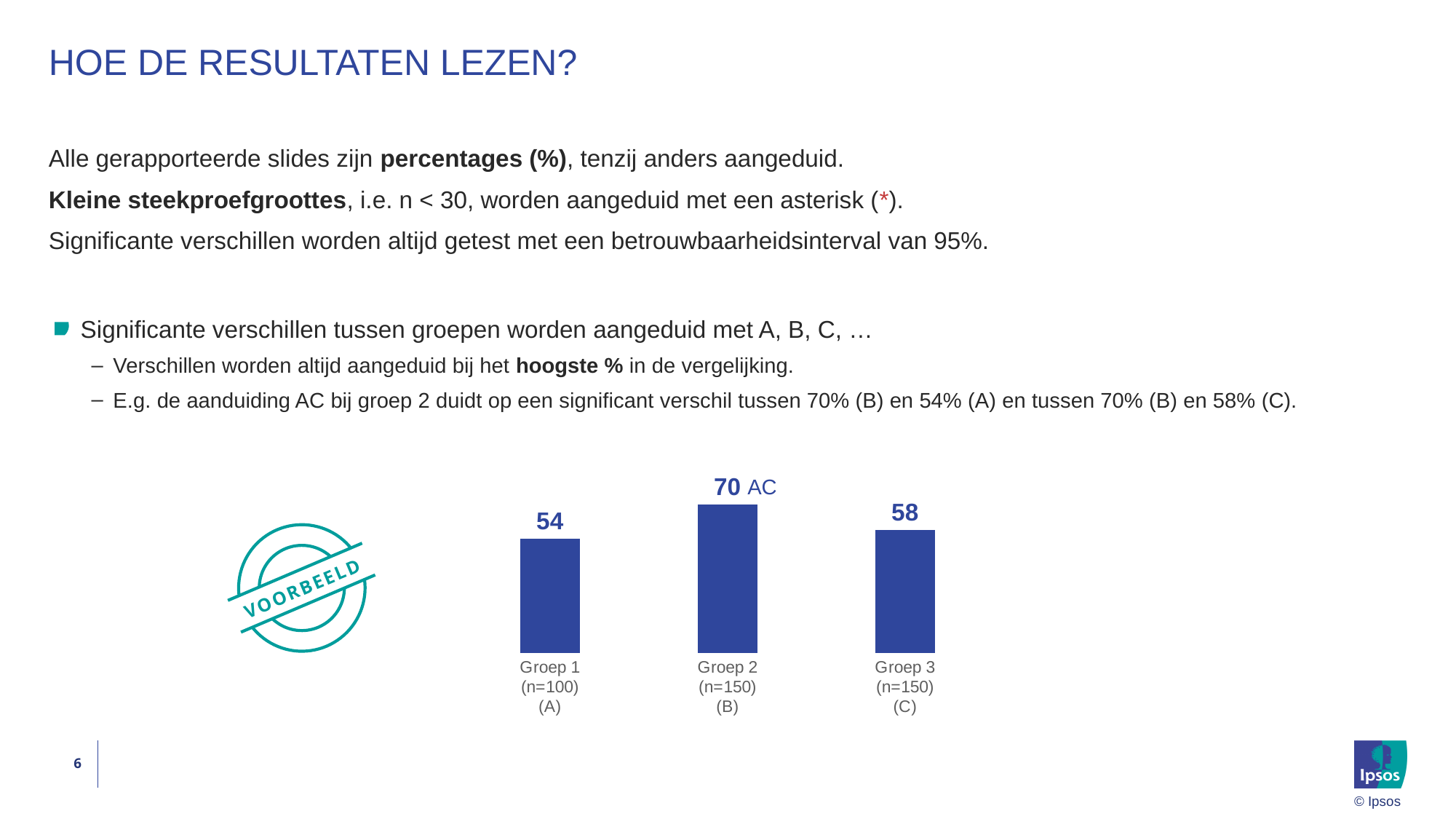
How many groups are shown in the chart? 3 What is the difference between the values for Groep 3 and Groep 1? 4 What is the value for Groep 1 (A)? 54 What is the value for Groep 3 (C)? 58 What kind of chart is shown on the slide? Bar chart Which letters are shown next to the data label of Groep 2? AC Which is larger, the value for Groep 3 or the value for Groep 1? Groep 3 Which group has the lowest value? Groep 1 What is the sample size (n) shown for Groep 1? n=100 Which group has the highest value? Groep 2 What is the value for Groep 2 (B)? 70 What is the difference between the values for Groep 2 and Groep 1? 16